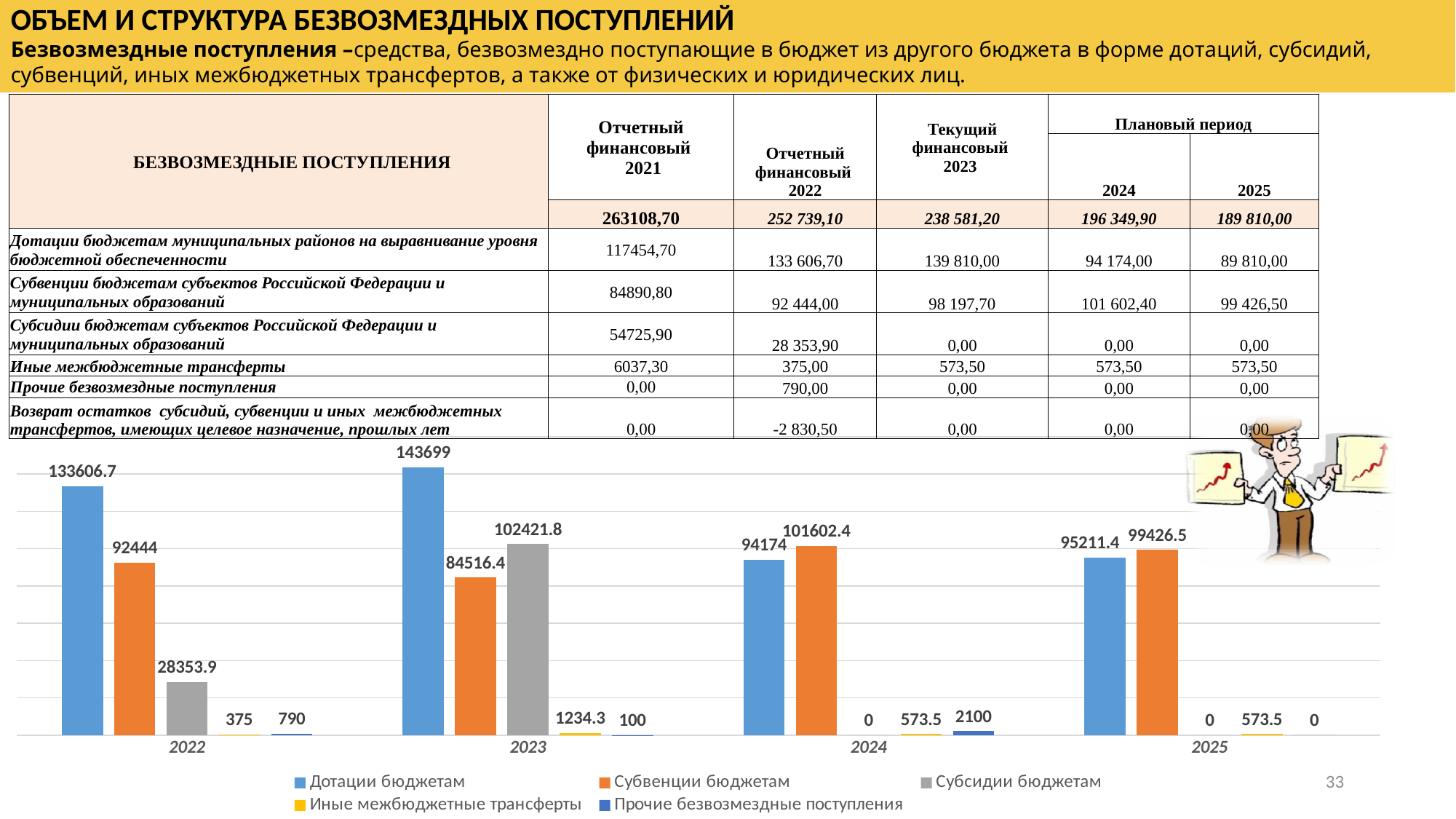
In the bar chart, which year has the highest value for Дотации бюджетам? 2023 What type of chart is shown at the bottom of the slide? bar chart In the bar chart, which year has the lowest value for Субвенции бюджетам? 2023 In the bar chart, what is the value for Прочие безвозмездные поступления in 2024? 2100 How many years are shown on the x axis of the bar chart? 4 In the bar chart, what is the value for Дотации бюджетам in 2023? 143699 How many series does the legend of the bar chart list? 5 In the bar chart, which is larger in 2025: Дотации бюджетам or Субвенции бюджетам? Субвенции бюджетам In the bar chart, what is the difference between Дотации бюджетам in 2023 and in 2022? 10092.3 In the bar chart, what is the value for Субсидии бюджетам in 2022? 28353.9 In the bar chart, what is the value for Субвенции бюджетам in 2024? 101602.4 In the bar chart, which colour represents Субсидии бюджетам? gray